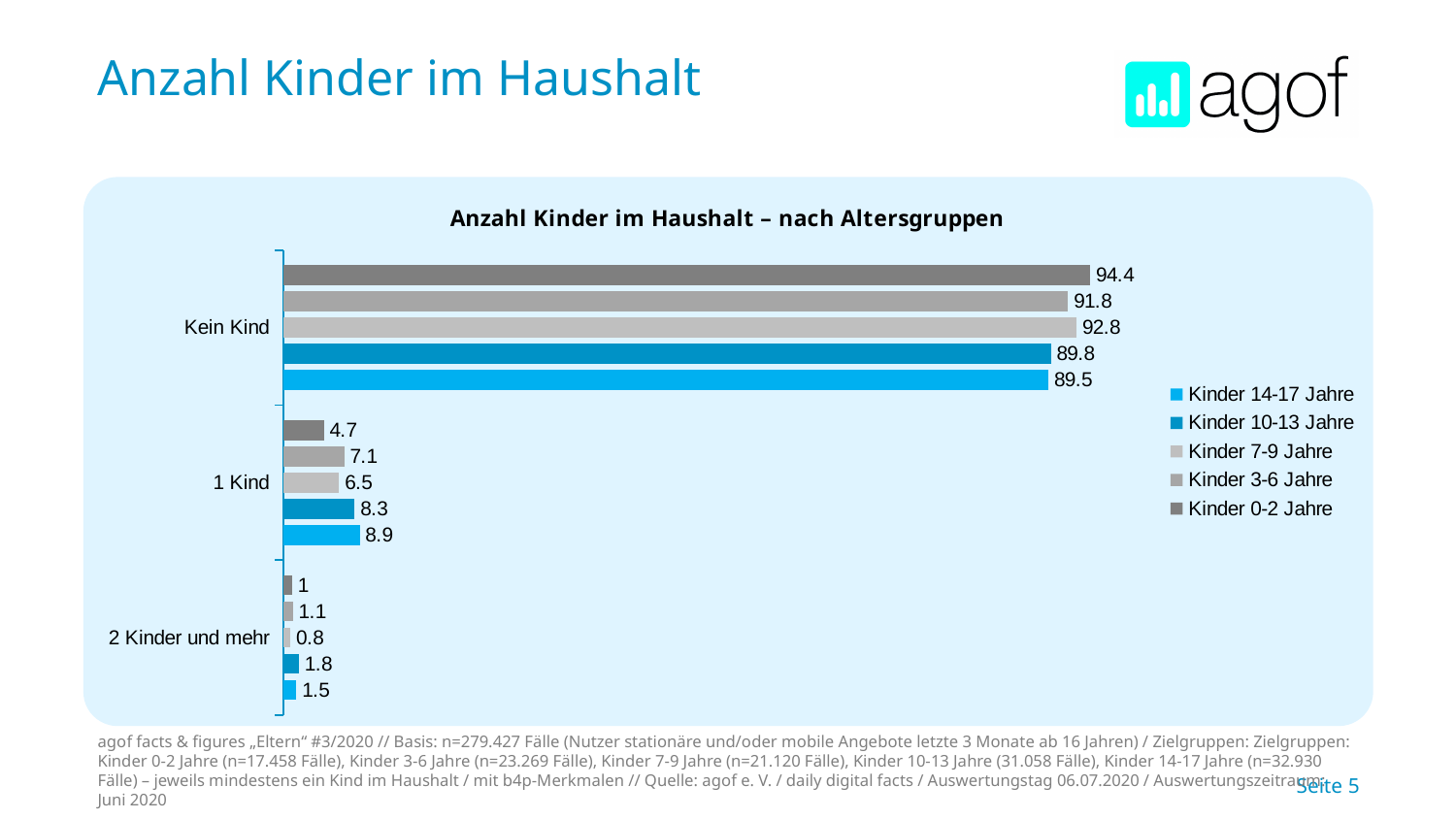
What is the value for Kinder 7-9 Jahre in the 2 Kinder und mehr category? 0.8 Which age group has the highest value in the Kein Kind category? Kinder 0-2 Jahre What type of chart is shown on the slide? Bar chart What is the difference between the Kinder 14-17 Jahre and Kinder 0-2 Jahre values in the 1 Kind category? 4.2 What is the value for Kinder 14-17 Jahre in the 1 Kind category? 8.9 In the 2 Kinder und mehr category, which is larger: the value for Kinder 10-13 Jahre or Kinder 14-17 Jahre? Kinder 10-13 Jahre What is the value for Kinder 0-2 Jahre in the Kein Kind category? 94.4 Which age group has the lowest value in the 1 Kind category? Kinder 0-2 Jahre How many series does the legend list? 5 What is the title of the chart? Anzahl Kinder im Haushalt – nach Altersgruppen How many categories are shown on the vertical axis of the chart? 3 What is the value for Kinder 10-13 Jahre in the Kein Kind category? 89.8